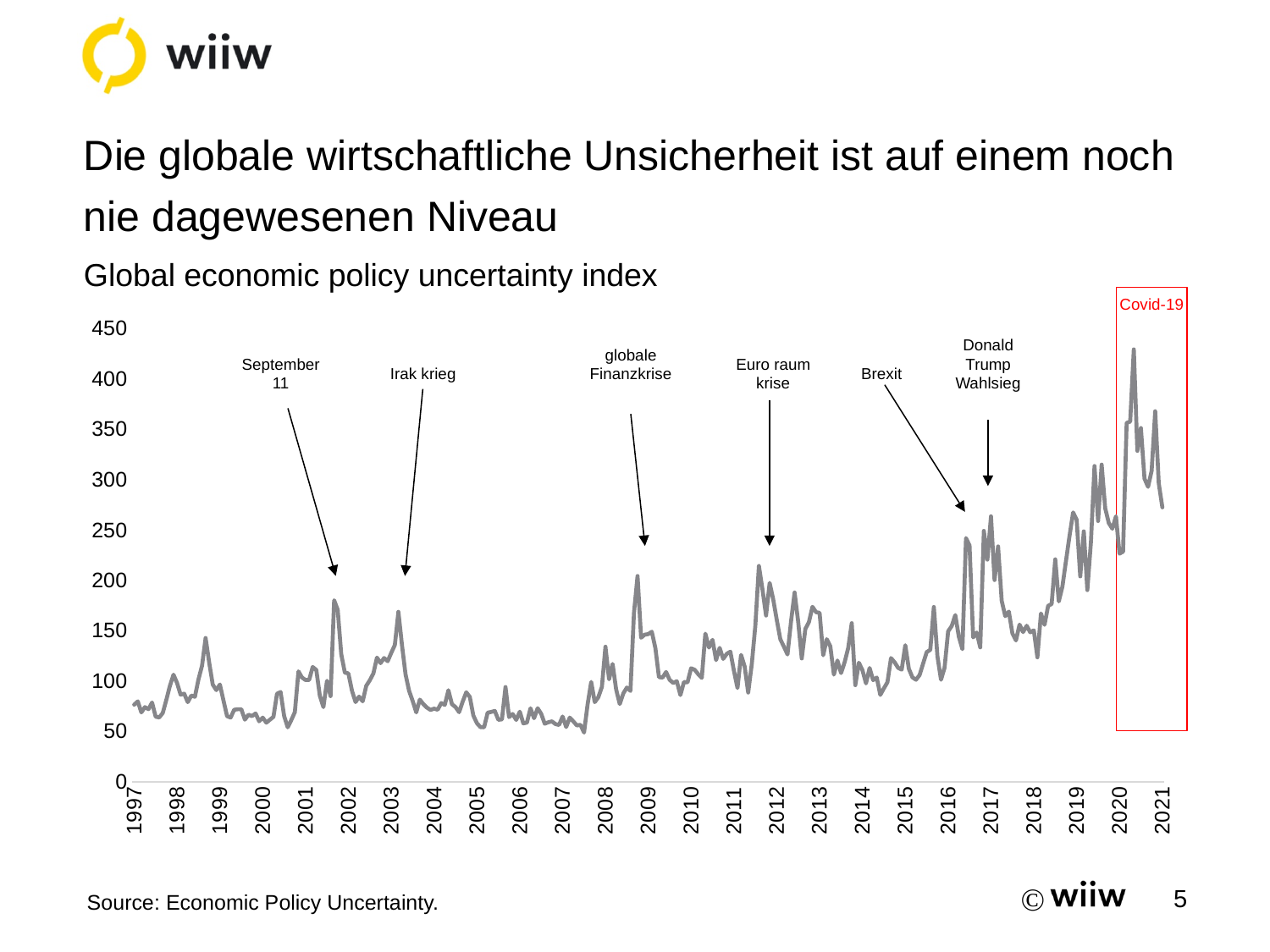
In which year does the index reach its highest value? 2020 What is the title of the chart? Global economic policy uncertainty index Is the peak value of the index in 2020 greater or less than 400? greater Which event is highlighted with a red box at the right end of the chart? Covid-19 How many lines are plotted on the chart? 1 What kind of chart is shown on the slide? line chart Is the value of the index at the start of 1997 greater or less than 100? less Is the peak of the index at the Brexit annotation greater or less than 200? greater Which peak is higher: the one at the Covid-19 period or the one at the Irak krieg annotation? Covid-19 Overall, does the index rise or fall from 2016 to 2020? rise Which peak is higher: the one at the Brexit annotation or the one at the September 11 annotation? Brexit